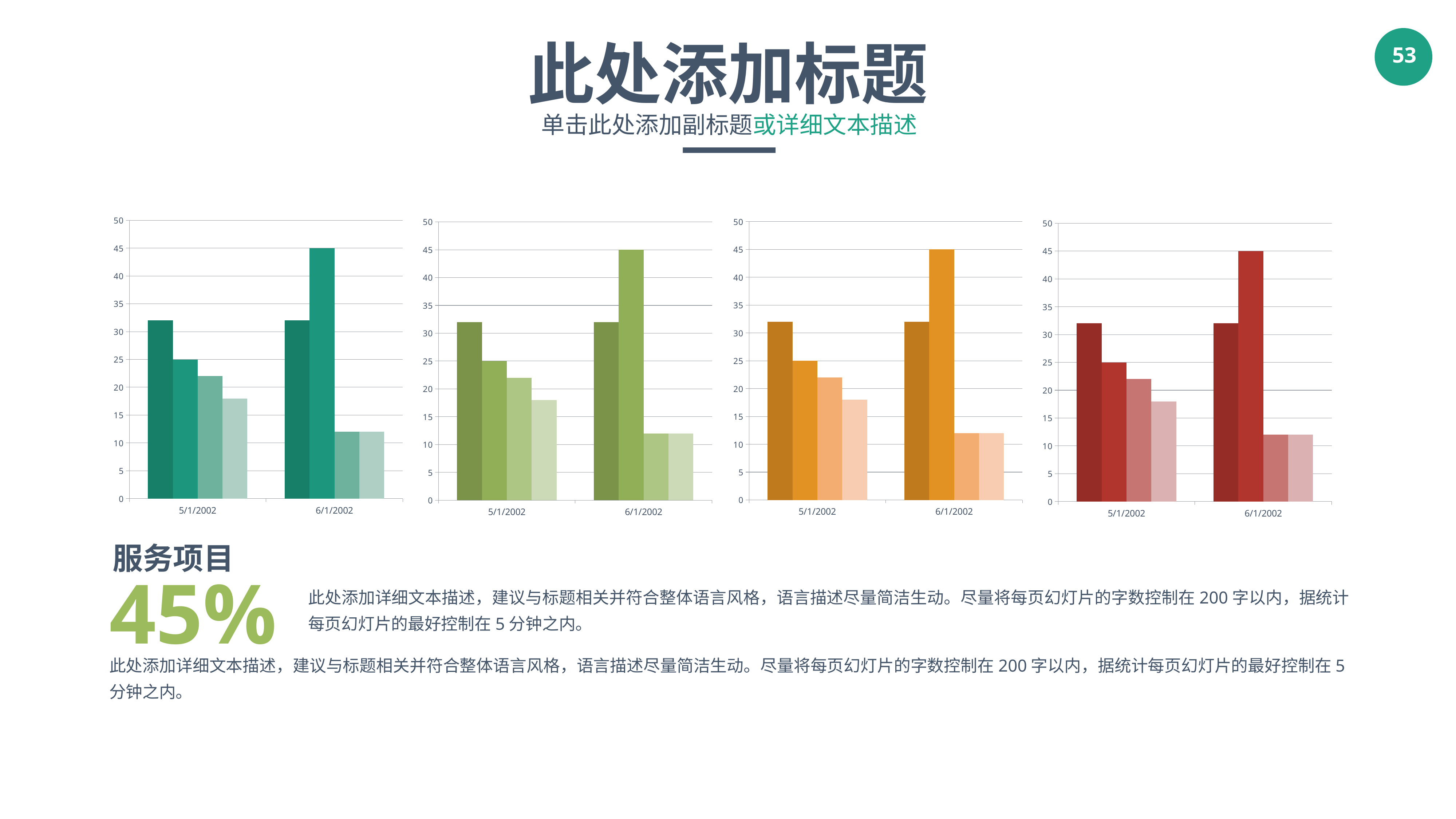
In the leftmost chart, is the value of the first (darkest) bar for 5/1/2002 greater or less than 30? greater In the red chart (rightmost), is the first bar for 5/1/2002 taller or shorter than the second bar for 5/1/2002? taller In the teal chart (leftmost), what value does the tallest bar for 6/1/2002 reach? 45 In the orange chart (third from left), is the value of the third bar for 5/1/2002 greater or less than 25? less How many charts are shown on the slide? 4 In the orange chart (third from left), which category contains the tallest bar? 6/1/2002 What is the highest value shown on the vertical axis of the green chart (second from left)? 50 What kind of chart is the leftmost chart on the slide? bar chart In the green chart (second from left), is the value of the fourth (lightest) bar for 6/1/2002 greater or less than 15? less In the teal chart (leftmost), how many bars are plotted for the 5/1/2002 category? 4 In the red chart (rightmost), what value does the second bar for 5/1/2002 reach? 25 In the orange chart (third from left), how many categories are shown on the x axis? 2